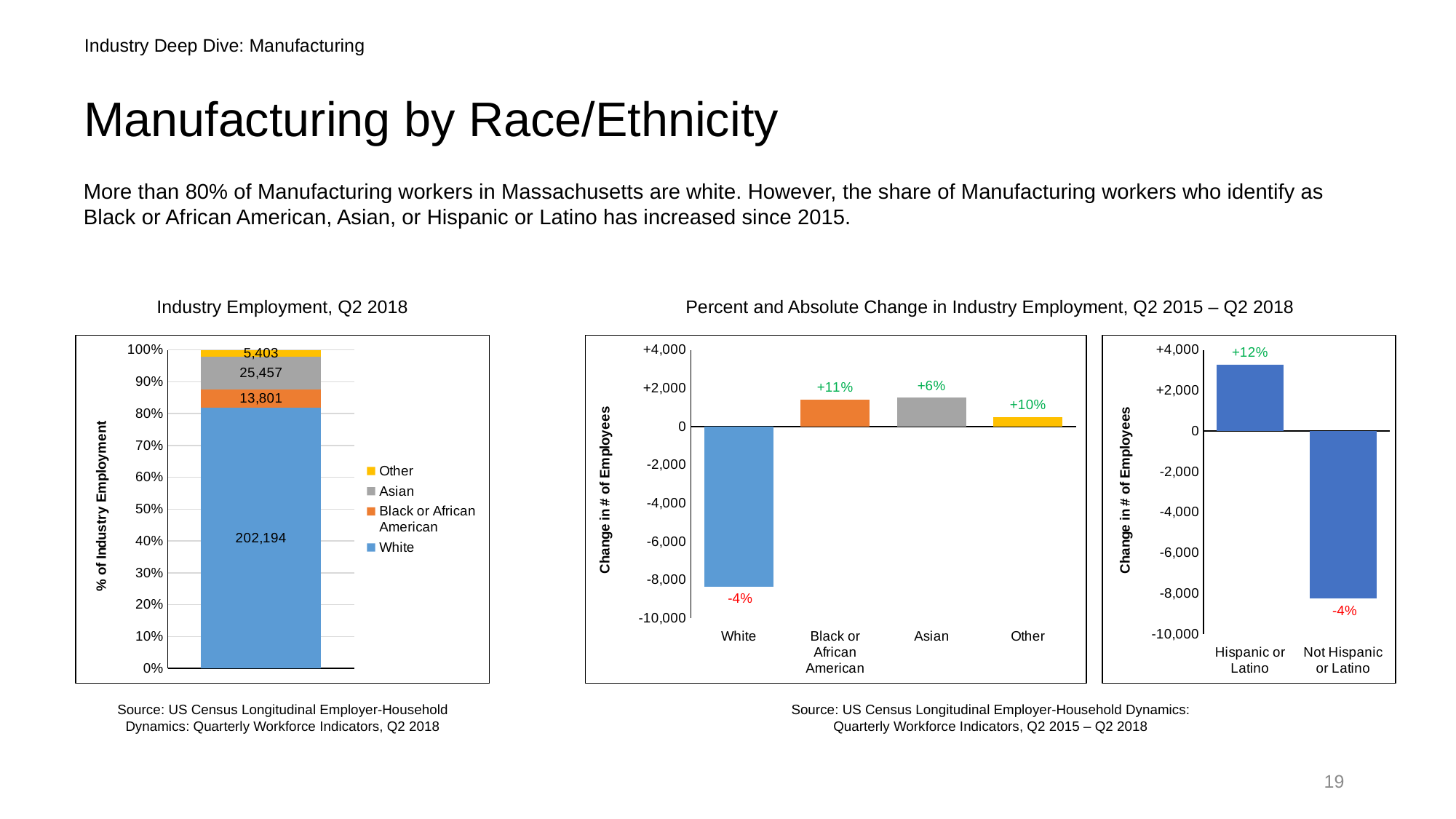
In the middle chart (change by race), what percent change is shown for Black or African American? +11% In the 'Industry Employment, Q2 2018' chart, what is the value shown for Asian? 25,457 In the right chart (change by Hispanic or Latino status), what percent change is shown for Hispanic or Latino? +12% In the right chart (change by Hispanic or Latino status), is the value for Hispanic or Latino greater or less than 2,000? greater In the 'Industry Employment, Q2 2018' chart, what is the value shown for Black or African American? 13,801 In the 'Industry Employment, Q2 2018' chart, what is the value shown for White? 202,194 In the 'Industry Employment, Q2 2018' chart, how many series does the legend list? 4 In the 'Industry Employment, Q2 2018' chart, what is the total of the stacked bar? 246,855 In the 'Industry Employment, Q2 2018' chart, what is the difference between the Asian and Other values? 20,054 In the middle chart (change by race), which category has the lowest change in number of employees? White In the middle chart (change by race), how many categories are shown on the x axis? 4 In the middle chart (change by race), is the value for White greater or less than -8,000? less